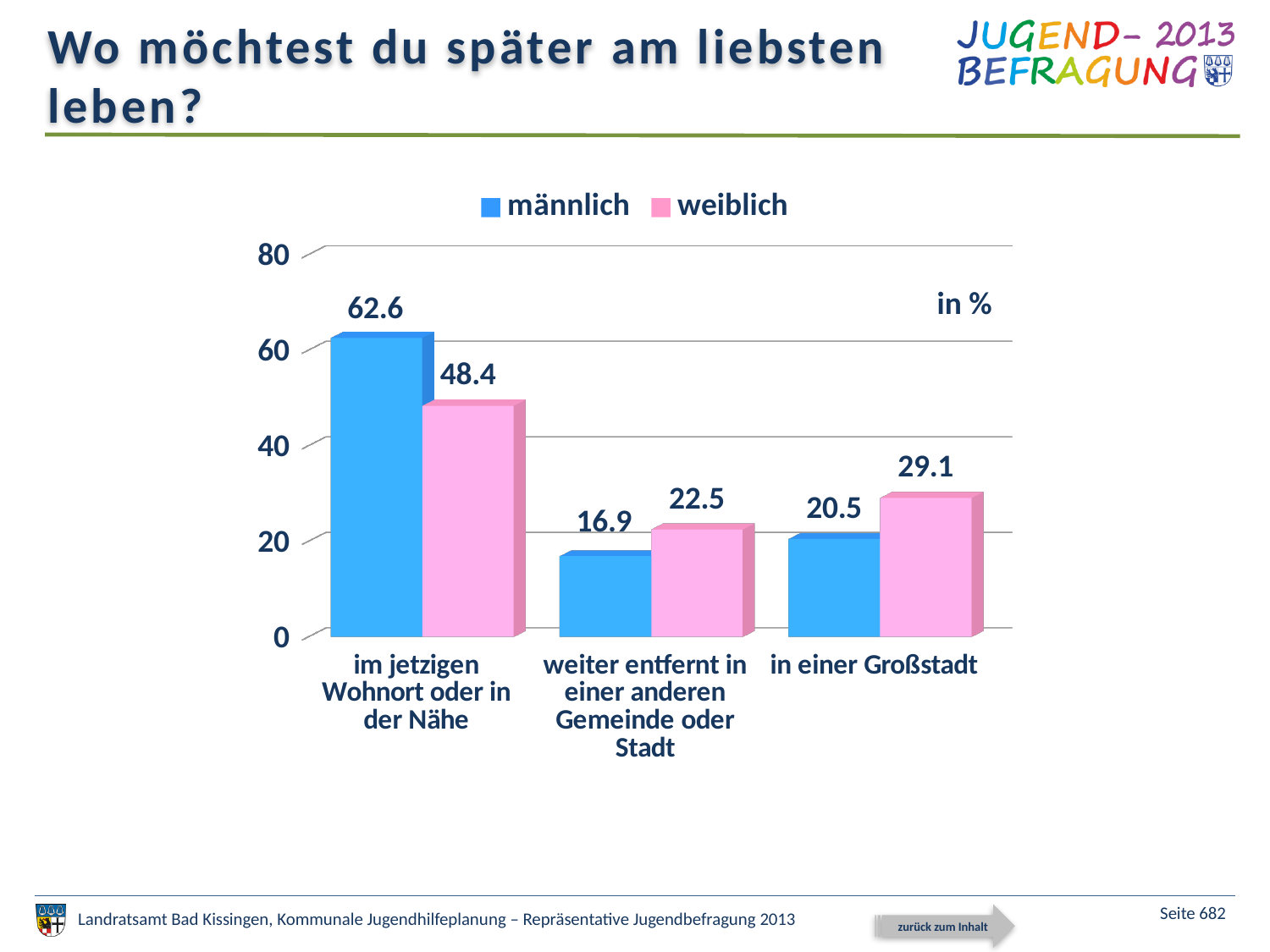
Is the weiblich value for 'im jetzigen Wohnort oder in der Nähe' greater or less than 40? greater What is the value for männlich in the category 'im jetzigen Wohnort oder in der Nähe'? 62.6 What is the difference between the männlich and weiblich values for 'im jetzigen Wohnort oder in der Nähe'? 14.2 How many series does the legend list? 2 Which category has the lowest value for männlich? weiter entfernt in einer anderen Gemeinde oder Stadt Which category has the highest value for weiblich? im jetzigen Wohnort oder in der Nähe Which colour represents the series 'weiblich' in the chart? pink Which is larger for 'in einer Großstadt': the männlich value or the weiblich value? weiblich What is the value for männlich in the category 'weiter entfernt in einer anderen Gemeinde oder Stadt'? 16.9 What is the value for weiblich in the category 'in einer Großstadt'? 29.1 What kind of chart is shown on the slide? bar chart How many categories are shown on the x axis? 3